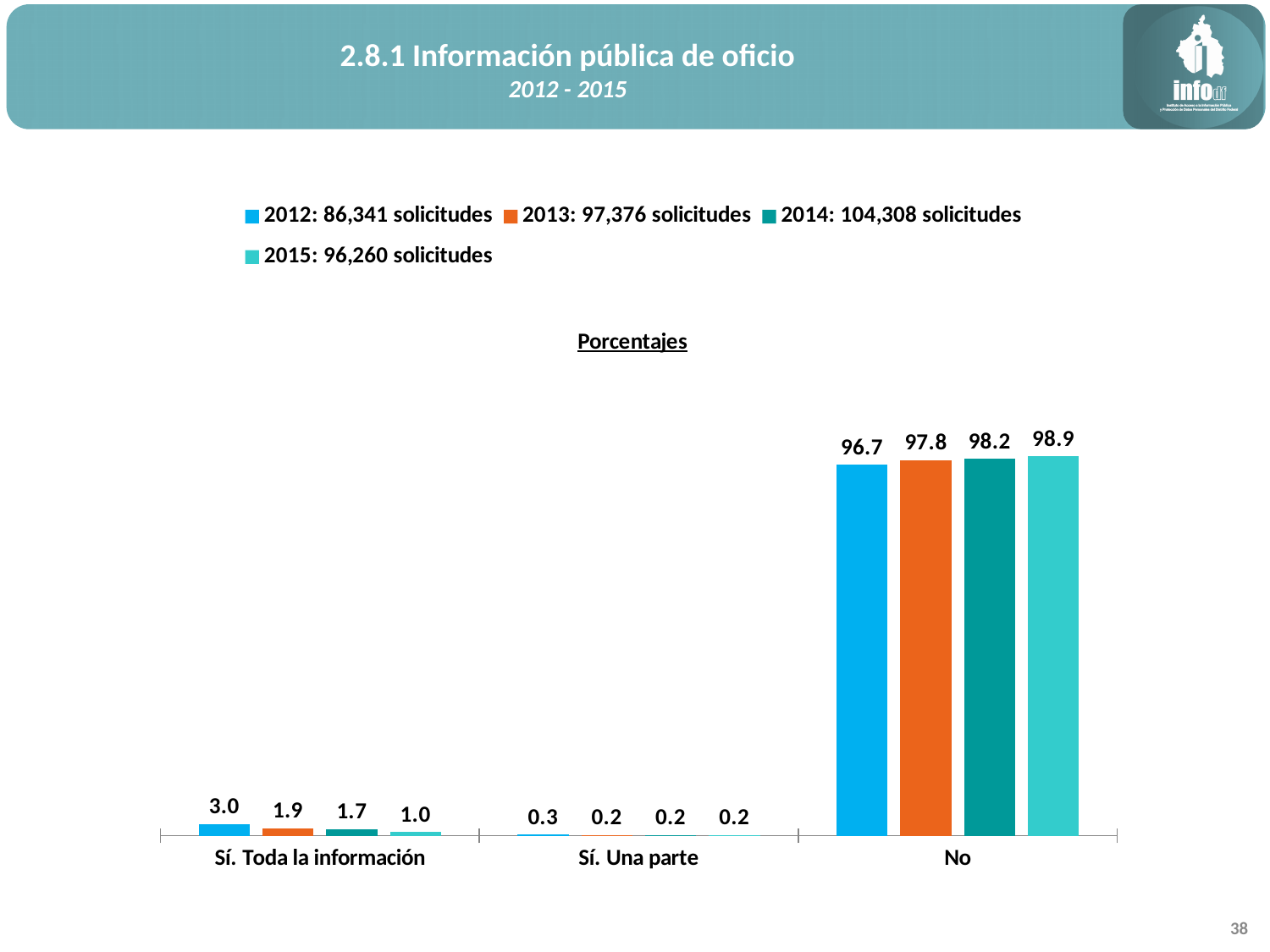
What kind of chart is shown on the slide? bar chart Which year has the highest value in the 'No' category? 2015 Which is larger in the 'Sí. Toda la información' category: the value for 2012 or the value for 2014? 2012 What is the value for 2012 in the 'No' category? 96.7 Which year has the lowest value in the 'Sí. Toda la información' category? 2015 Do the values in the 'No' category rise or fall from 2012 to 2015? rise According to the legend, how many solicitudes were there in 2014? 104,308 solicitudes What is the value for 2013 in the 'Sí. Una parte' category? 0.2 What is the value for 2015 in the 'Sí. Toda la información' category? 1.0 How many series does the legend list? 4 How many categories are shown on the x axis? 3 What is the difference between the 2015 and 2012 values in the 'No' category? 2.2